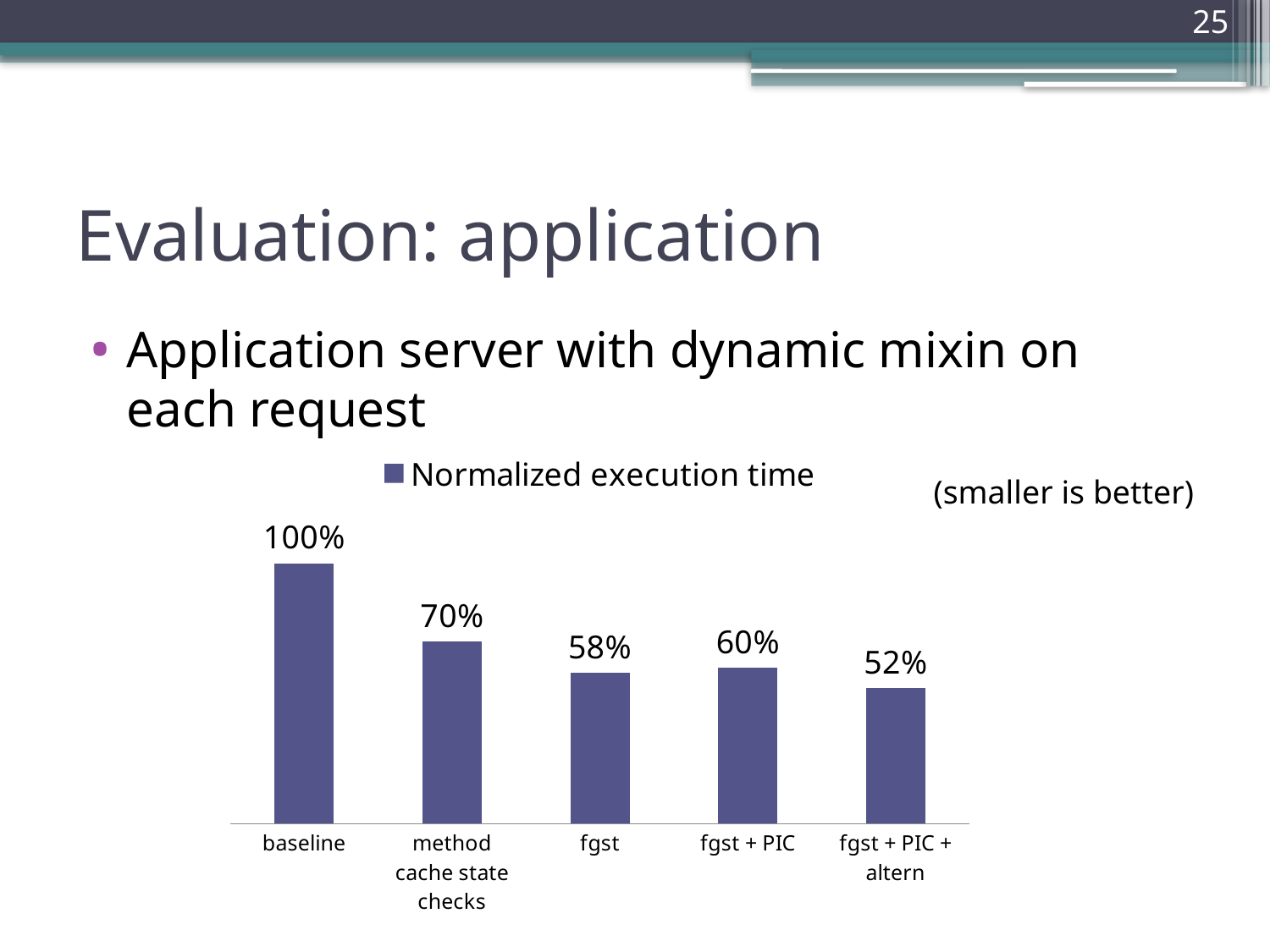
What kind of chart is shown on the slide? bar chart Which category has the highest normalized execution time? baseline What is the difference in normalized execution time between fgst + PIC and fgst + PIC + altern? 8% How many series does the legend list? 1 What is the normalized execution time for fgst + PIC + altern? 52% Which has a larger normalized execution time, fgst or fgst + PIC? fgst + PIC What is the normalized execution time for method cache state checks? 70% What is the difference in normalized execution time between baseline and fgst? 42% What is the legend entry of the chart? Normalized execution time What is the normalized execution time for baseline? 100% Which category has the lowest normalized execution time? fgst + PIC + altern How many categories are shown in the chart? 5